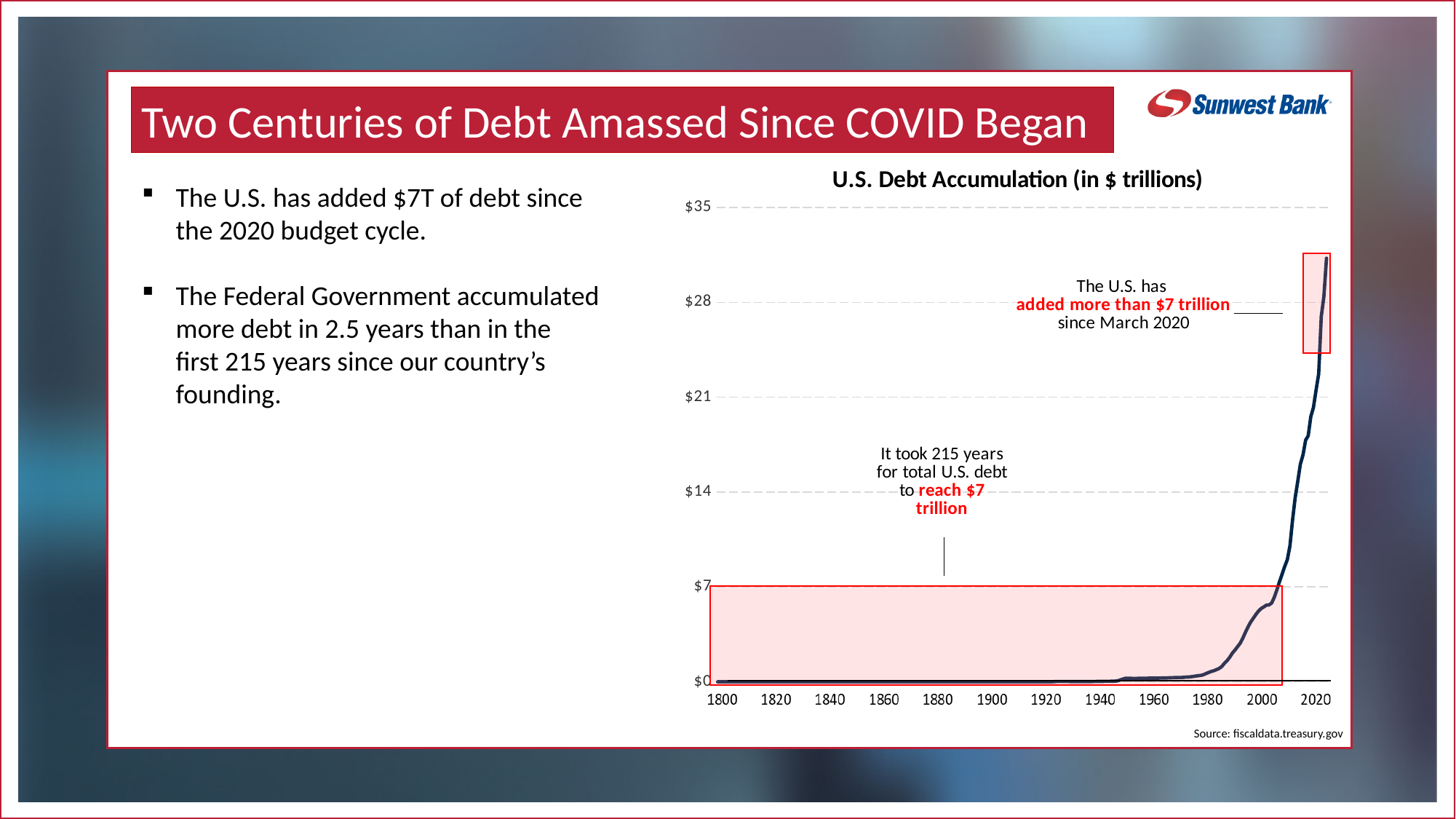
What is the title of the chart? U.S. Debt Accumulation (in $ trillions) How many year labels are shown on the x axis? 12 Is the value for 2020 greater or less than $28? less Which is larger, the debt value in 1960 or in 2020? 2020 Is the value for 1980 greater or less than $7? less Is the value for 2000 greater or less than $7? less Which year shown on the x axis has the highest debt value? 2020 What is the highest value labelled on the y axis? $35 What kind of chart is shown on the slide? line chart Does U.S. debt rise or fall along the x axis from 1800 to 2020? rise